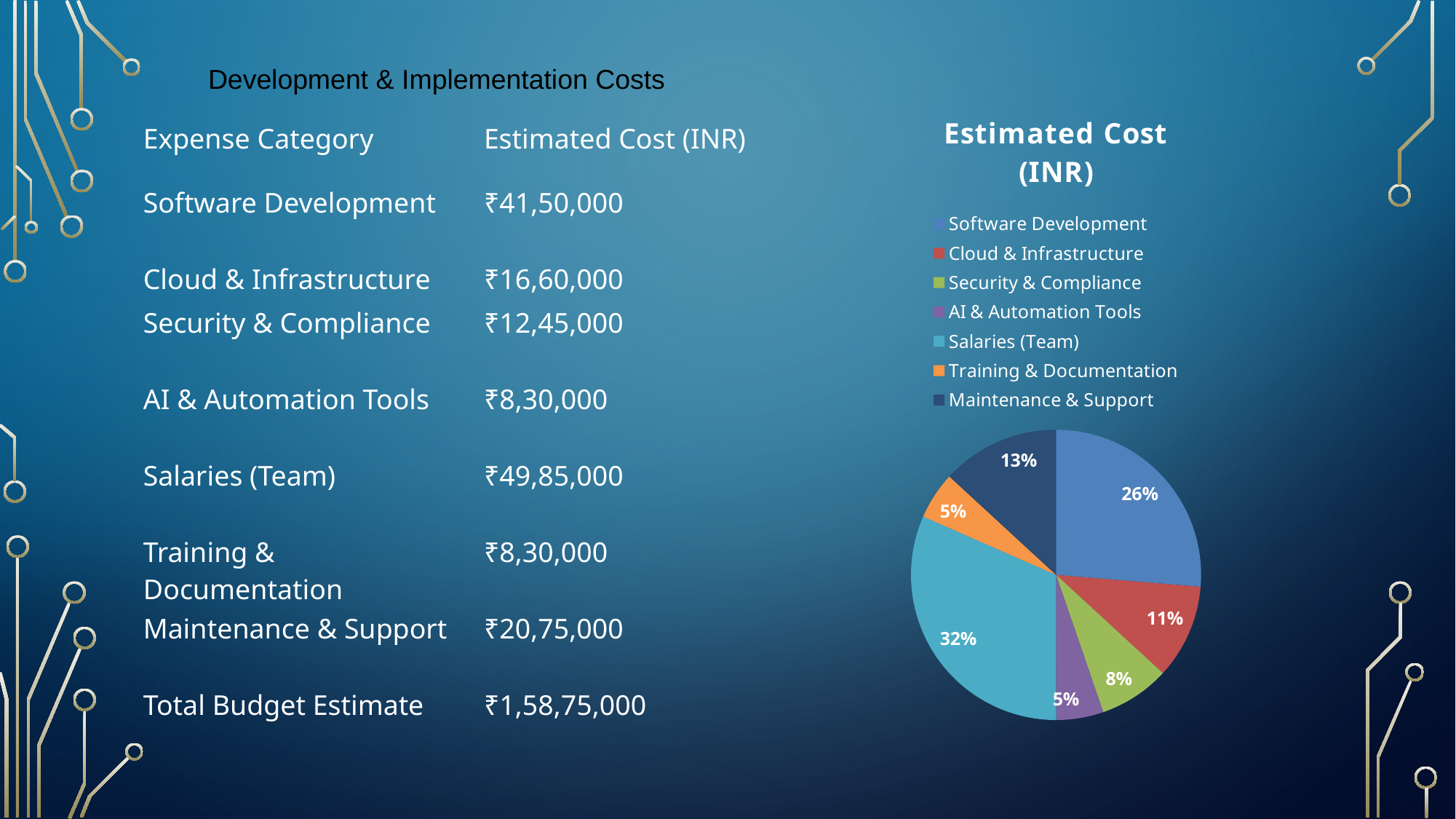
What share of the pie chart does Software Development represent? 26% What is the title of the pie chart? Estimated Cost (INR) What share of the pie chart does Security & Compliance represent? 8% How many slices does the pie chart have? 7 What share of the pie chart does Maintenance & Support represent? 13% Which category has the largest slice in the pie chart? Salaries (Team) What is the difference in percentage points between the Salaries (Team) slice and the Software Development slice? 6 percentage points Which is larger in the pie chart, the share for Cloud & Infrastructure or the share for Maintenance & Support? Maintenance & Support How many entries does the pie chart's legend list? 7 What type of chart is shown on the slide? pie chart